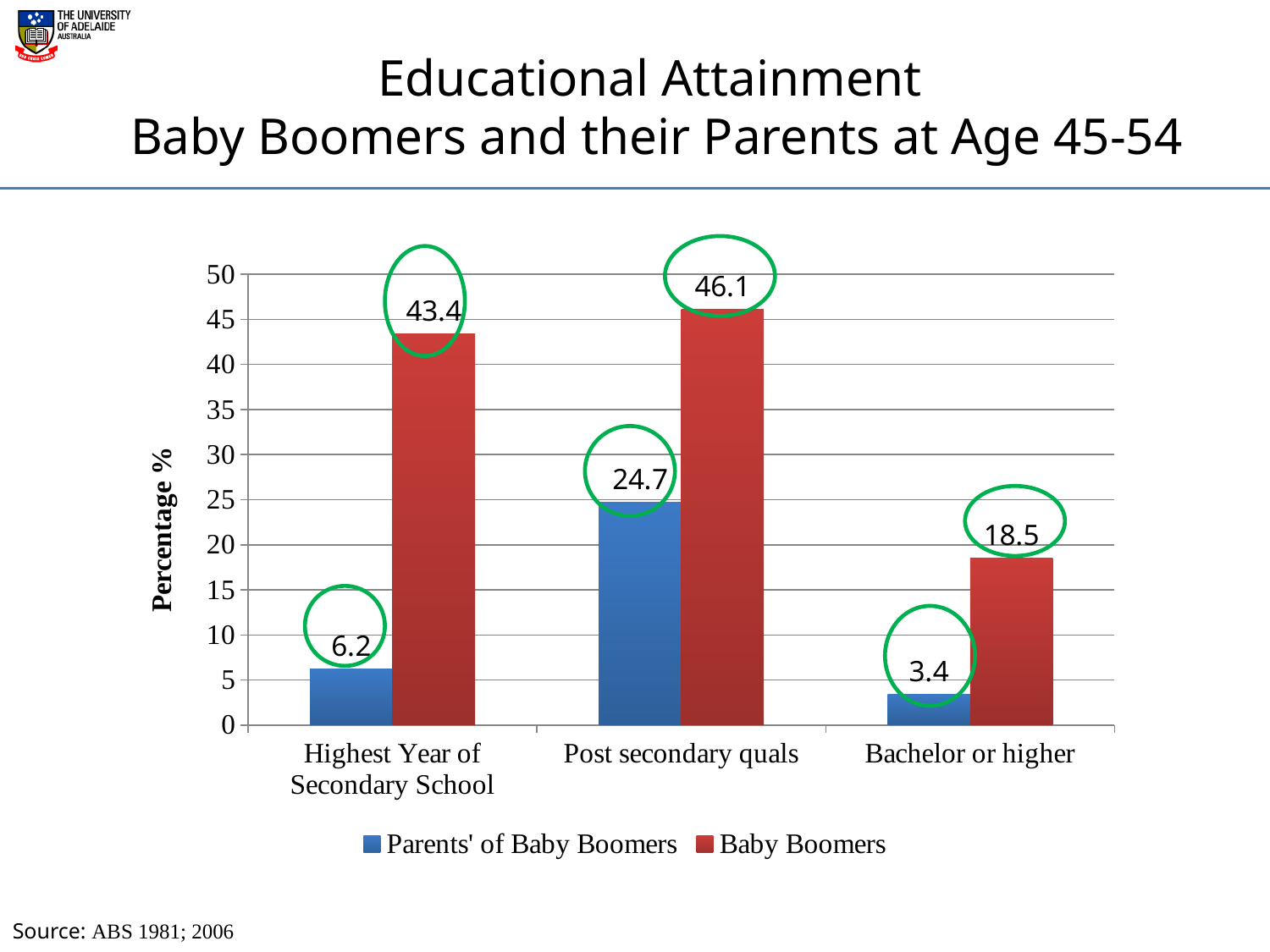
What kind of chart is shown on the slide? Bar chart Which category has the lowest value for Parents' of Baby Boomers? Bachelor or higher How many categories are shown on the x axis? 3 What is the value for Baby Boomers in the Post secondary quals category? 46.1 Is the value for Baby Boomers in the Highest Year of Secondary School category greater or less than 40? greater What is the value for Baby Boomers in the Bachelor or higher category? 18.5 Which category has the highest value for Baby Boomers? Post secondary quals How many series does the legend list? 2 What is the value for Parents' of Baby Boomers in the Post secondary quals category? 24.7 What is the difference between Baby Boomers and Parents' of Baby Boomers in the Highest Year of Secondary School category? 37.2 What is the value for Parents' of Baby Boomers in the Highest Year of Secondary School category? 6.2 Which is larger in the Bachelor or higher category: Baby Boomers or Parents' of Baby Boomers? Baby Boomers